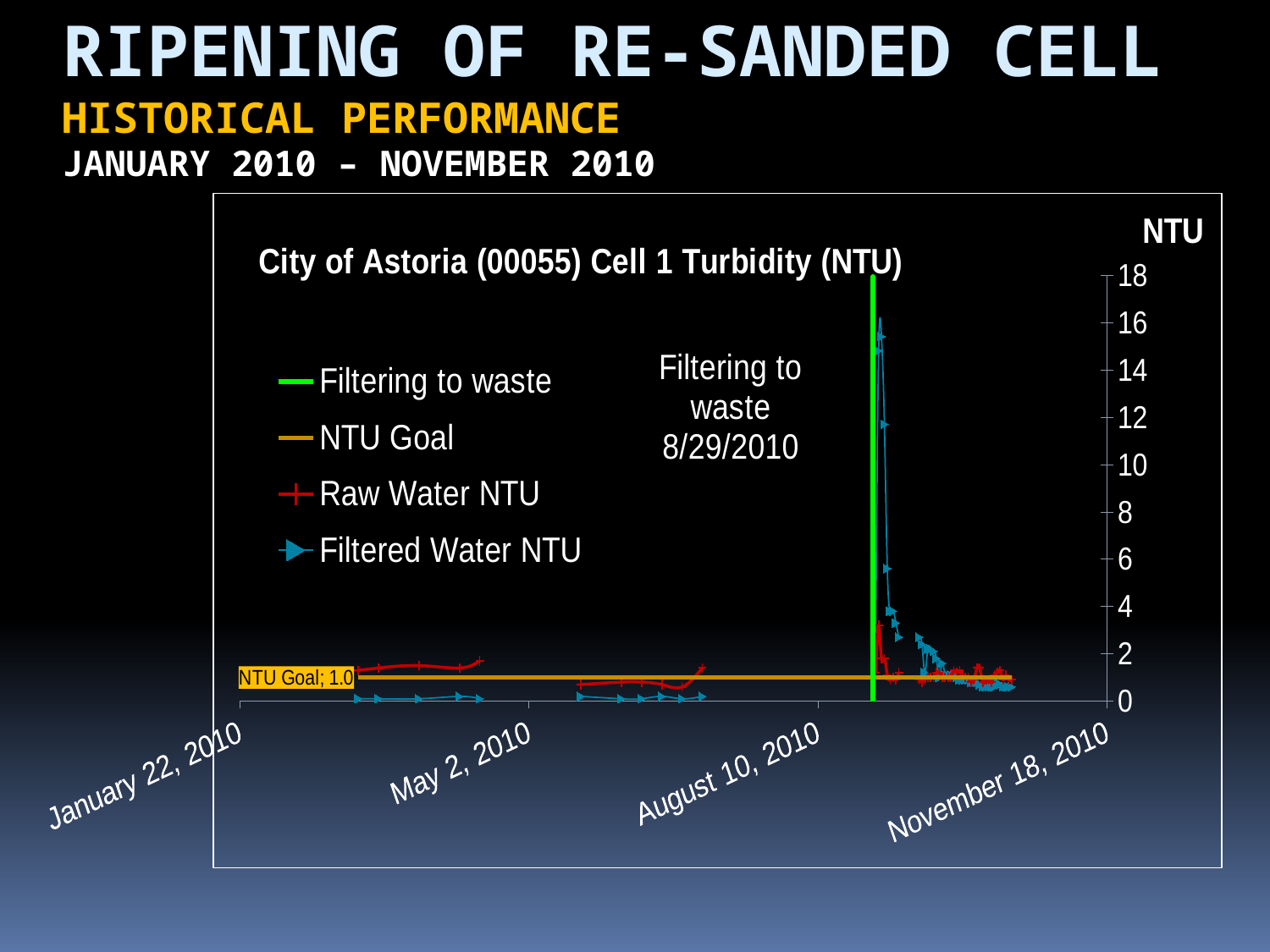
What value is printed for the NTU Goal line? 1.0 What is the highest tick value shown on the vertical axis? 18 Is the Raw Water NTU around May 2, 2010 greater or less than 4? less On what date did filtering to waste occur, according to the chart annotation? 8/29/2010 How many date labels are shown on the horizontal axis? 4 Is the Filtered Water NTU before May 2, 2010 greater or less than 2? less Which series reaches the highest value on the chart? Filtered Water NTU What kind of chart is shown on the slide? line chart What is the title of the chart? City of Astoria (00055) Cell 1 Turbidity (NTU) Is the peak value of Filtered Water NTU greater or less than 14? greater How many series does the chart legend list? 4 After the spike at the filtering-to-waste line, does the Filtered Water NTU rise or fall toward November 18, 2010? fall